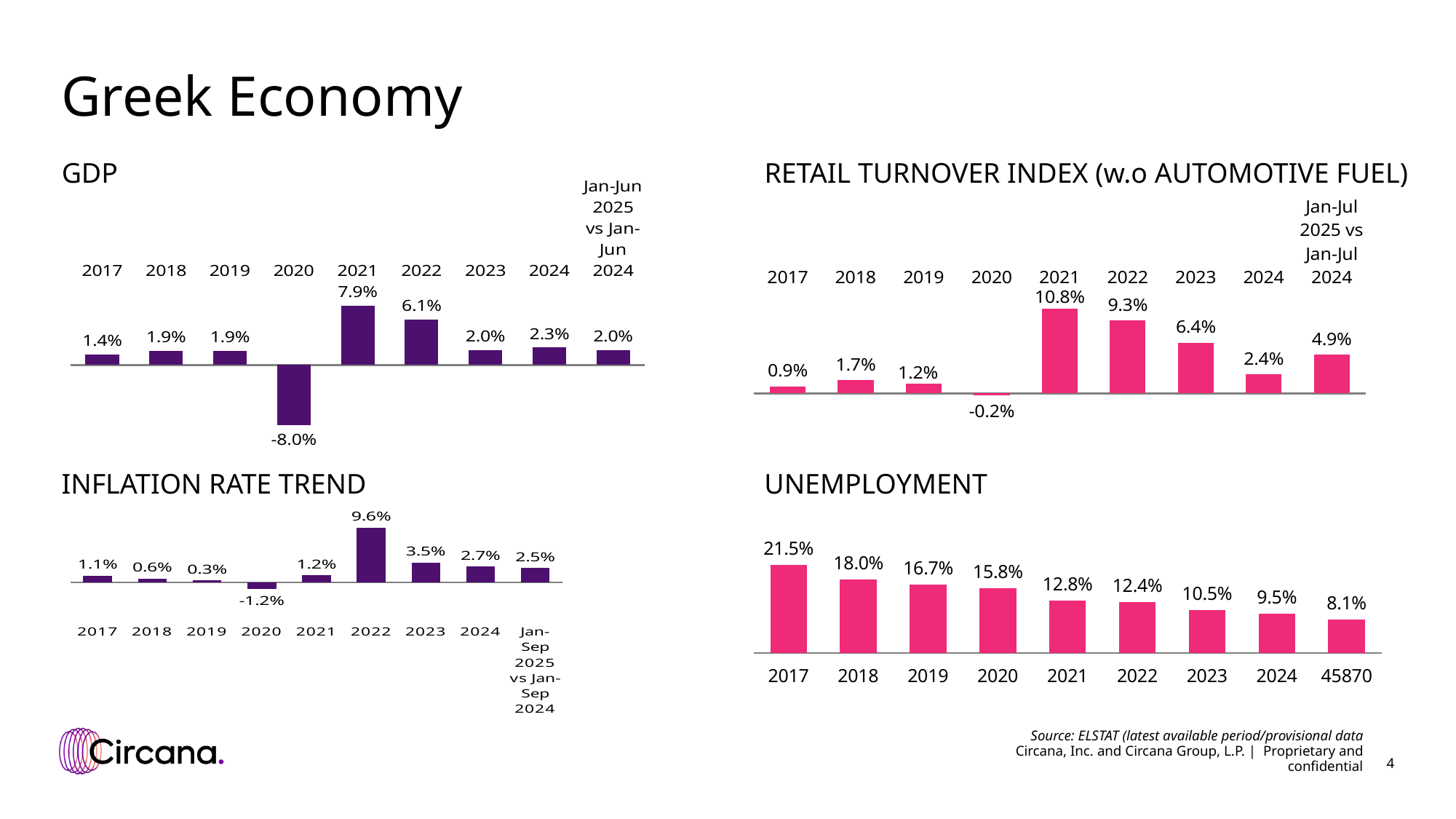
In the Retail Turnover Index chart, what is the value for 2023? 6.4% In the Inflation Rate Trend chart, what is the value for 2022? 9.6% In the Inflation Rate Trend chart, what is the value for 2020? -1.2% In the Retail Turnover Index chart, which is larger, the value for 2022 or the value for 2024? 2022 In the GDP chart, what is the difference between the 2021 and 2022 values? 1.8% In the Retail Turnover Index chart, which year has the lowest value? 2020 In the GDP chart, which year has the highest value? 2021 In the Unemployment chart, what is the value for 2017? 21.5% In the GDP chart, what is the value for 2020? -8.0% In the Unemployment chart, what is the difference between the 2017 and 2018 values? 3.5% How many charts are shown on the slide? 4 In the Unemployment chart, do the values rise or fall from 2017 to 2024? fall